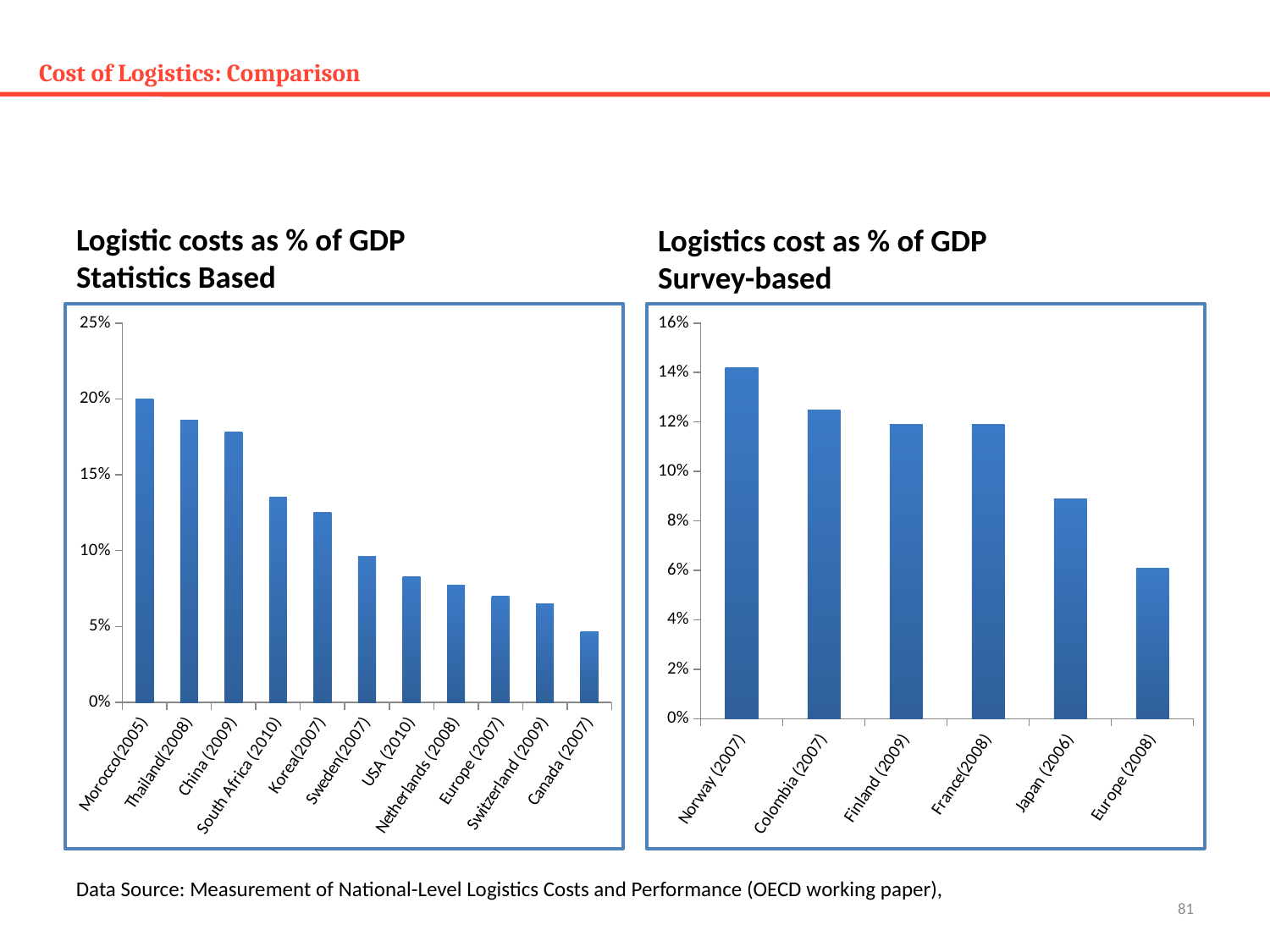
In the left chart (Statistics Based), which category has the highest logistic cost as % of GDP? Morocco(2005) In the right chart (Survey-based), is the value for Japan (2006) greater or less than 8%? greater How many categories are plotted in the right chart (Survey-based)? 6 How many categories are plotted in the left chart (Statistics Based)? 11 In the left chart (Statistics Based), is the value for South Africa (2010) greater or less than 15%? less In the left chart (Statistics Based), which category has the lowest logistic cost as % of GDP? Canada (2007) In the left chart (Statistics Based), do the values rise or fall from left to right along the x axis? fall In the right chart (Survey-based), which category has the highest logistics cost as % of GDP? Norway (2007) In the right chart (Survey-based), which category has the lowest logistics cost as % of GDP? Europe (2008) In the left chart (Statistics Based), which is larger, China (2009) or Korea(2007)? China (2009) What kind of chart is the 'Logistic costs as % of GDP Statistics Based' chart on the left? bar chart In the left chart (Statistics Based), is the value for Thailand(2008) greater or less than 15%? greater